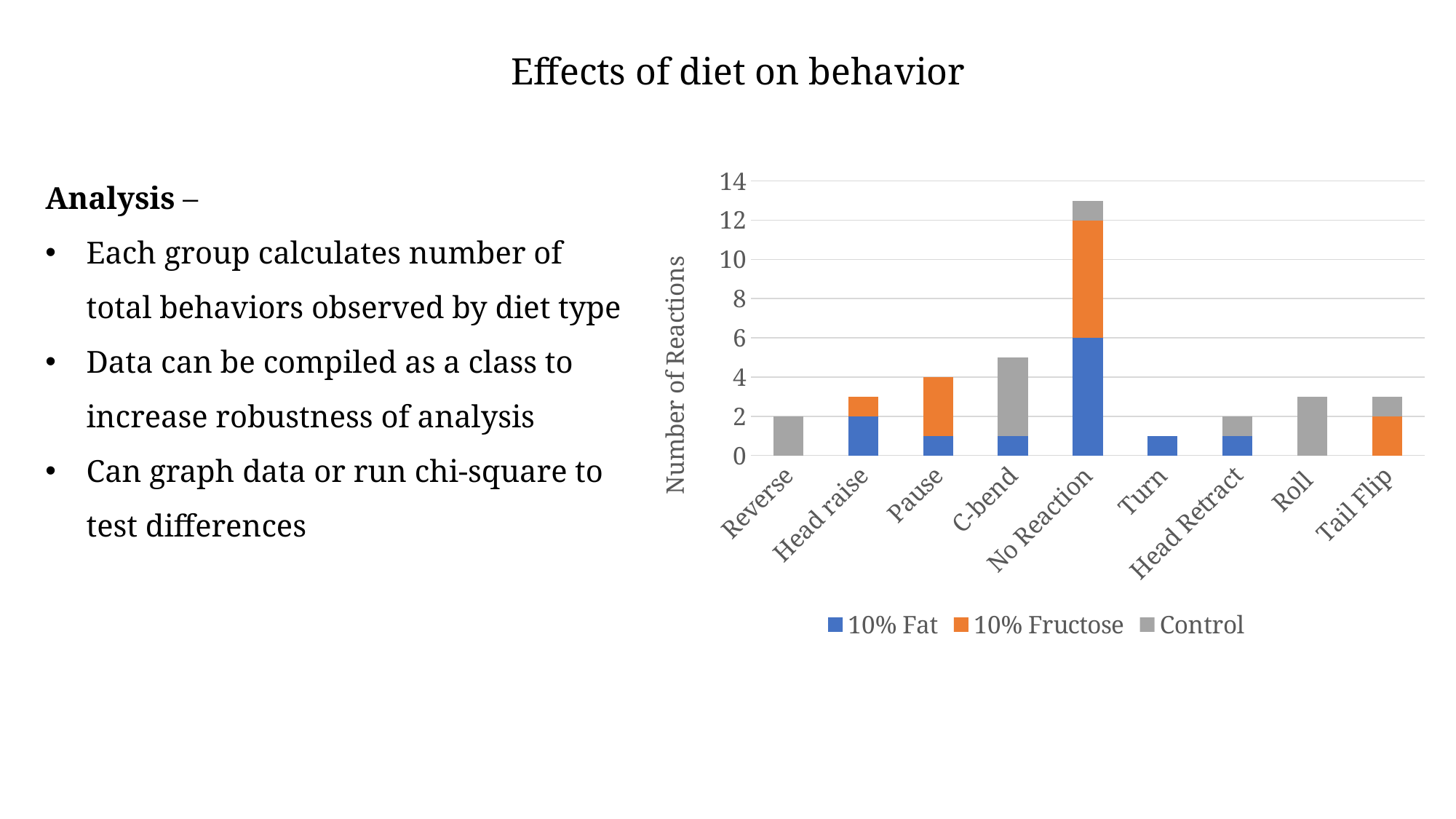
What kind of chart is shown on the slide? bar chart Which has a taller stacked bar, No Reaction or C-bend? No Reaction Is the total number of reactions for No Reaction greater or less than 12? greater Which behavior category has the shortest stacked bar? Turn Which behavior category has the tallest stacked bar? No Reaction What is the total number of reactions for Pause? 4 What is the 10% Fat value for No Reaction? 6 How many series does the legend list? 3 How many behavior categories are shown on the x axis? 9 What is the total number of reactions for Reverse? 2 What is the label on the y axis? Number of Reactions Is the total number of reactions for Roll greater or less than 4? less